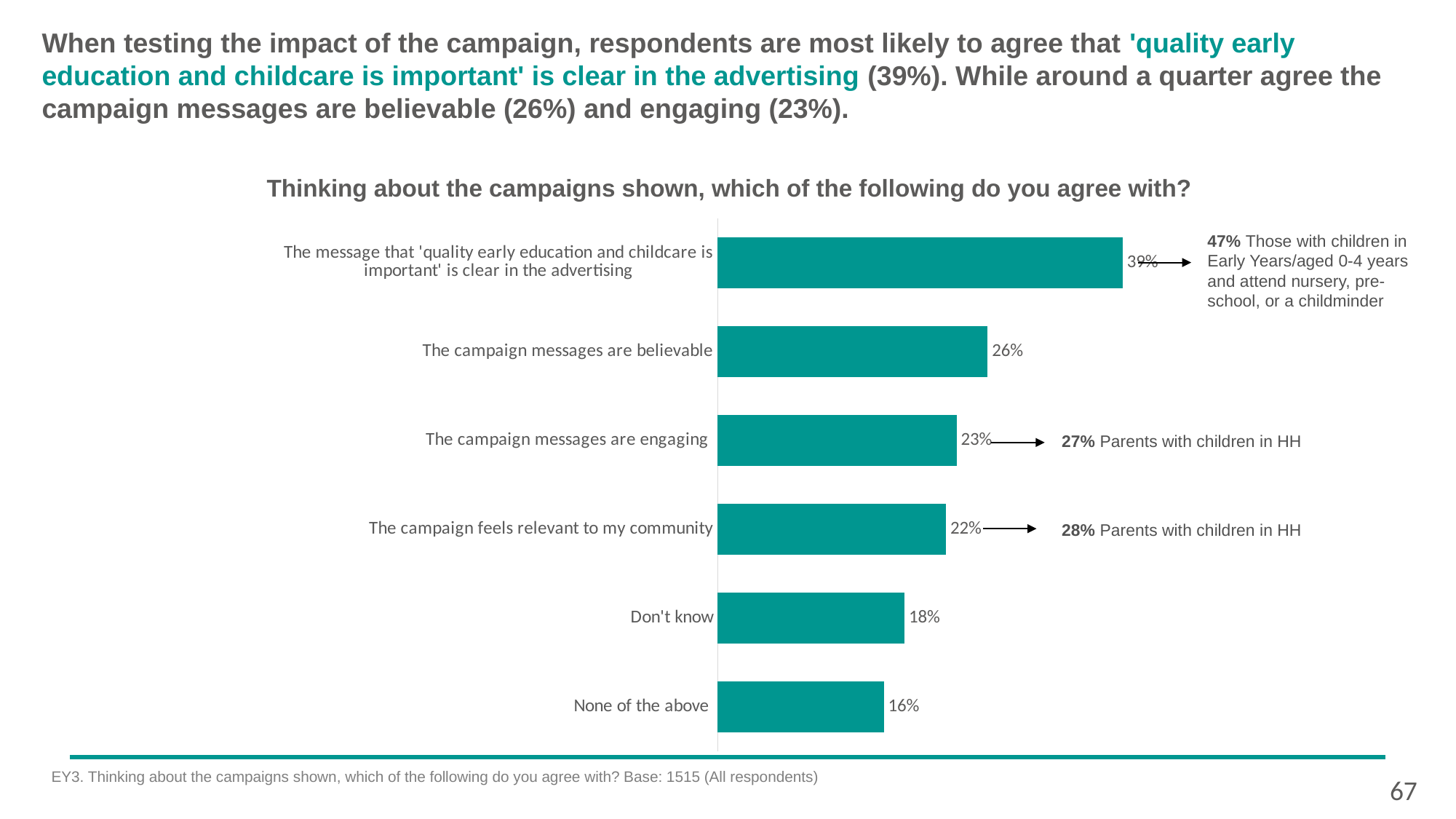
Which is larger: the percentage agreeing the campaign messages are engaging or the percentage answering 'Don't know'? The campaign messages are engaging What percentage of respondents answered 'Don't know'? 18% What type of chart is shown on the slide? Bar chart What percentage of respondents selected 'None of the above'? 16% What is the difference between the percentage agreeing the campaign messages are believable and the percentage selecting 'None of the above'? 10% What percentage of respondents agree that the campaign feels relevant to their community? 22% What percentage of respondents agree that the campaign messages are engaging? 23% What is the title of the chart? Thinking about the campaigns shown, which of the following do you agree with? Which statement has the highest level of agreement? The message that 'quality early education and childcare is important' is clear in the advertising Which category has the lowest value in the chart? None of the above How many categories are shown in the chart? 6 What percentage of respondents agree that the campaign messages are believable? 26%